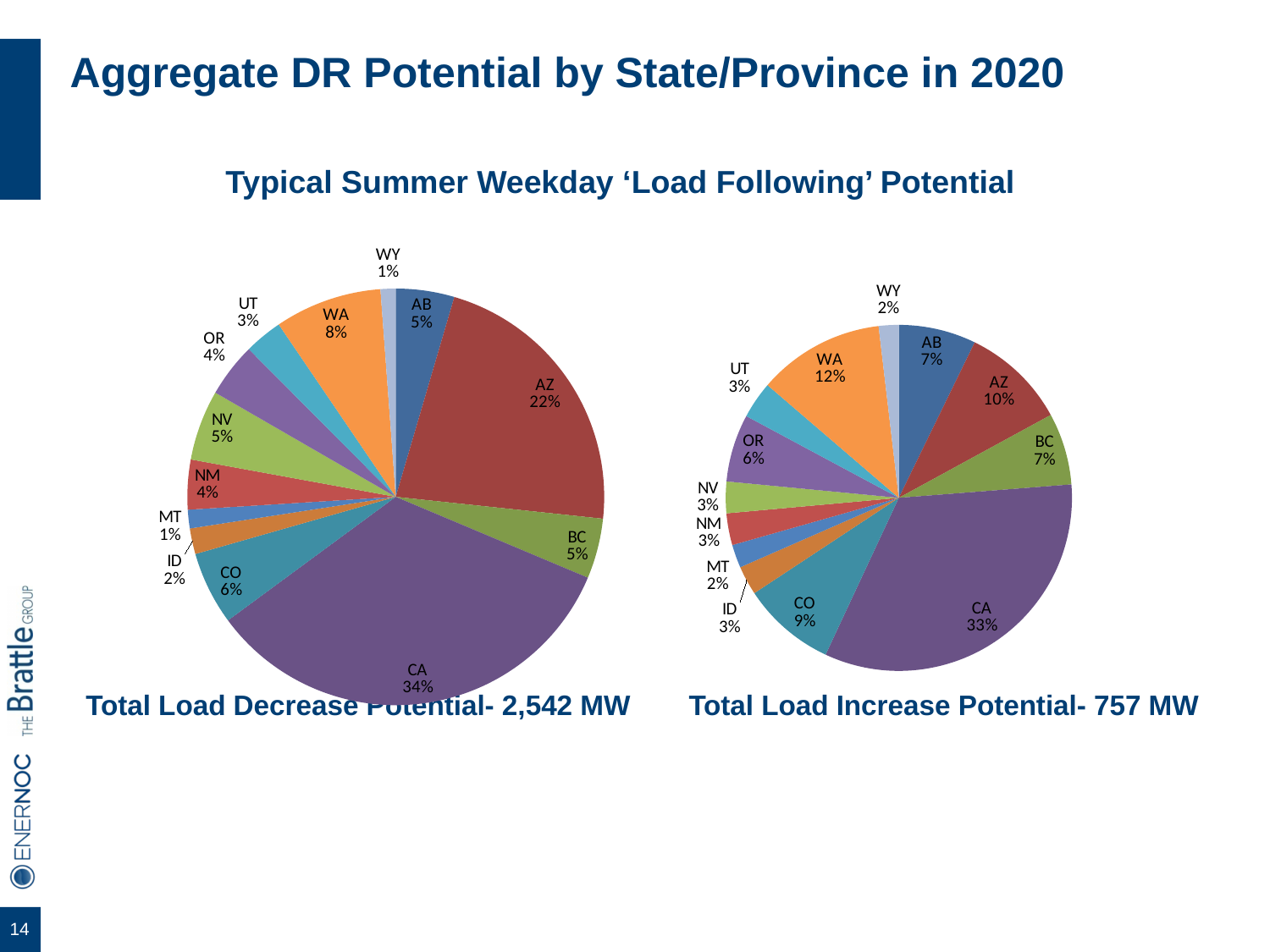
In the Total Load Decrease Potential pie chart, what share does CA have? 34% In the Total Load Decrease Potential pie chart, what is the share for AZ? 22% What type of chart is used for the Total Load Increase Potential? Pie chart In the Total Load Decrease Potential pie chart, what is the difference in percentage points between CA and AZ? 12 In the Total Load Increase Potential pie chart, which is larger, the share for CO or the share for OR? CO What total is given for the Total Load Increase Potential chart? 757 MW How many states/provinces are shown in the Total Load Decrease Potential pie chart? 13 In the Total Load Increase Potential pie chart, what is the share for AZ? 10% In the Total Load Increase Potential pie chart, what share does WA have? 12% What total is given for the Total Load Decrease Potential chart? 2,542 MW In the Total Load Decrease Potential pie chart, which state/province has the largest slice? CA In the Total Load Increase Potential pie chart, which state/province has the largest slice? CA